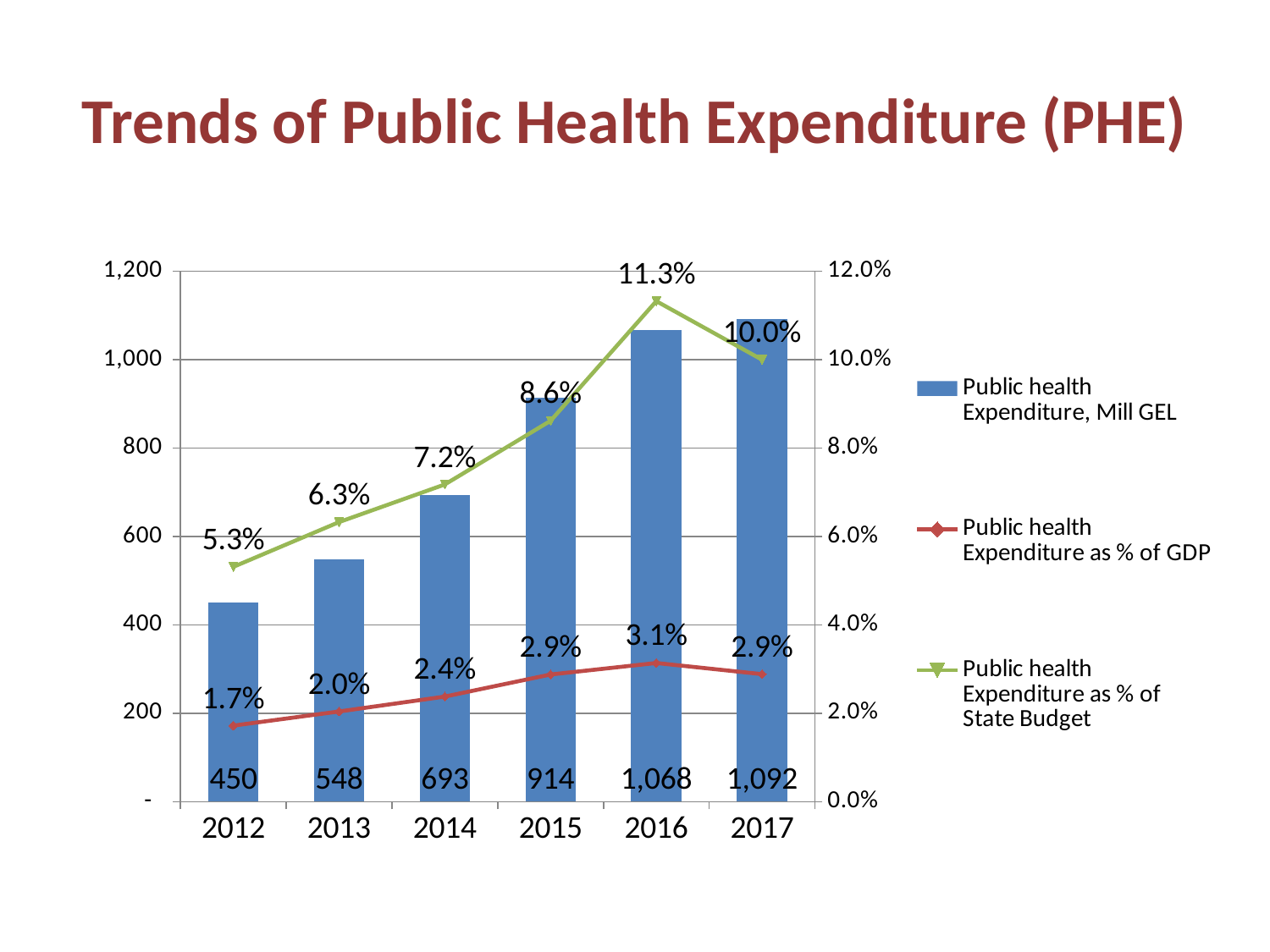
Which year has the highest Public health Expenditure in Mill GEL? 2017 What is the difference in Public health Expenditure (Mill GEL) between 2017 and 2016? 24 How many series does the legend list? 3 What is the title of the slide? Trends of Public Health Expenditure (PHE) What is the Public health Expenditure as % of State Budget in 2016? 11.3% Does the Public health Expenditure in Mill GEL rise or fall from 2012 to 2017? Rise What is the Public health Expenditure in Mill GEL for 2015? 914 Which year has the lowest Public health Expenditure as % of GDP? 2012 What is the Public health Expenditure as % of GDP in 2014? 2.4% Which year has the higher Public health Expenditure as % of State Budget, 2016 or 2017? 2016 What kind of chart is shown on the slide? Combined bar and line chart How many years are shown on the x axis? 6